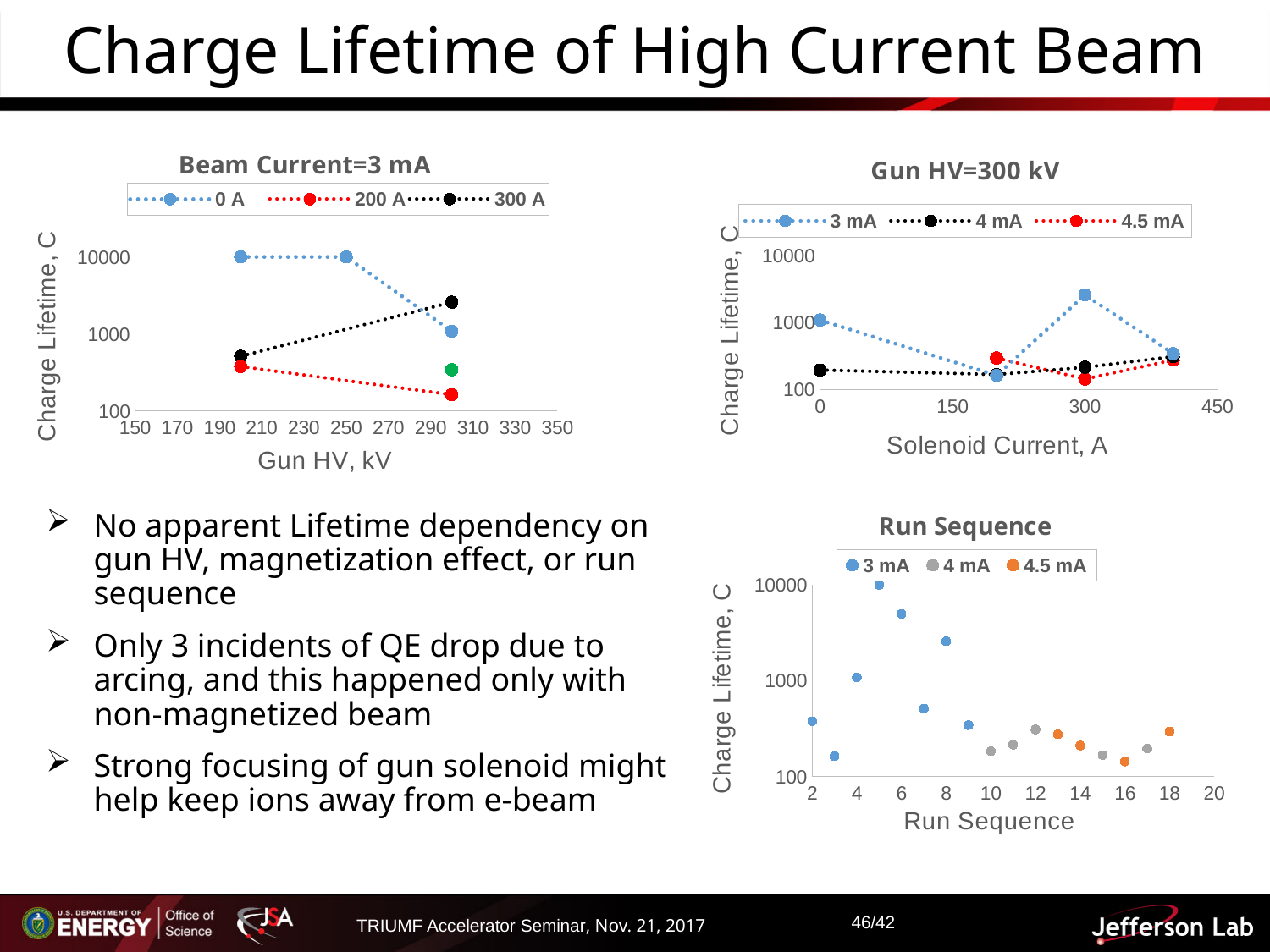
How many series does the legend of the 'Beam Current=3 mA' chart list? 3 In the 'Run Sequence' chart, how many 4.5 mA points are plotted? 4 What is the x-axis title of the 'Gun HV=300 kV' chart? Solenoid Current, A What are the legend entries of the 'Run Sequence' chart? 3 mA, 4 mA, 4.5 mA What kind of chart is the 'Beam Current=3 mA' chart? scatter chart In the 'Gun HV=300 kV' chart, is the value for the 3 mA series at 300 A greater or less than 1000? greater In the 'Run Sequence' chart, at which run sequence number is the charge lifetime highest? 5 In the 'Beam Current=3 mA' chart, does the 200 A series rise or fall from 200 kV to 300 kV? fall In the 'Beam Current=3 mA' chart, is the value for the 200 A series at 300 kV greater or less than 1000? less In the 'Beam Current=3 mA' chart, is the value for the 0 A series at 300 kV greater or less than 10000? less In the 'Beam Current=3 mA' chart, at 300 kV, which series has the larger charge lifetime: 300 A or 200 A? 300 A How many series does the legend of the 'Gun HV=300 kV' chart list? 3